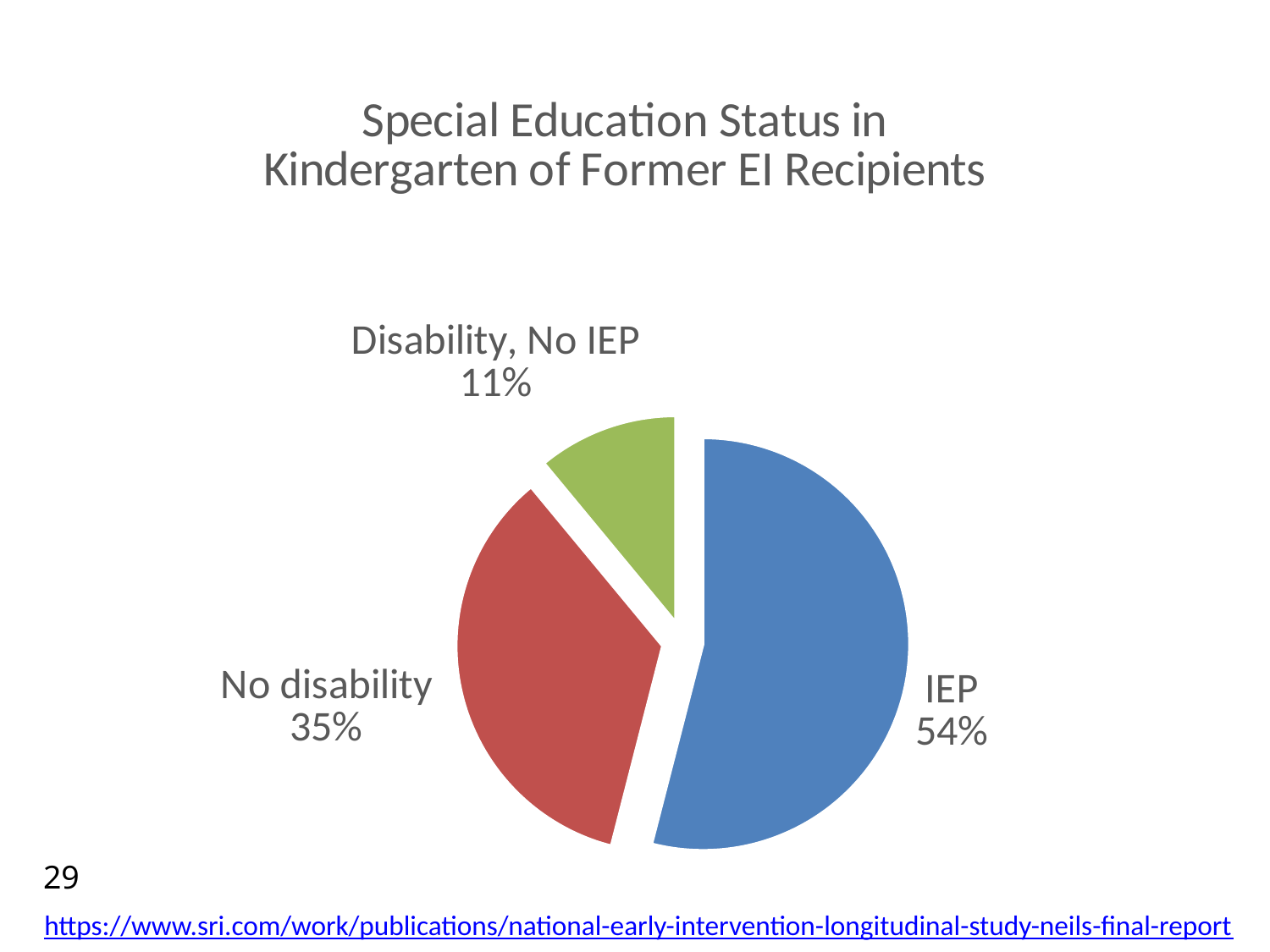
What is the difference in percentage points between the No disability slice and the Disability, No IEP slice? 24 What percentage of former EI recipients had a disability but no IEP? 11% What is the difference in percentage points between the IEP slice and the No disability slice? 19 How many slices does the pie chart have? 3 What percentage of former EI recipients had no disability in kindergarten? 35% Which category has the largest share of the pie? IEP Which category has the smallest share of the pie? Disability, No IEP Which is larger, the No disability slice or the Disability, No IEP slice? No disability What colour is the IEP slice? blue What percentage of former EI recipients had an IEP in kindergarten? 54% What is the title of the chart? Special Education Status in Kindergarten of Former EI Recipients What kind of chart is shown on the slide? pie chart